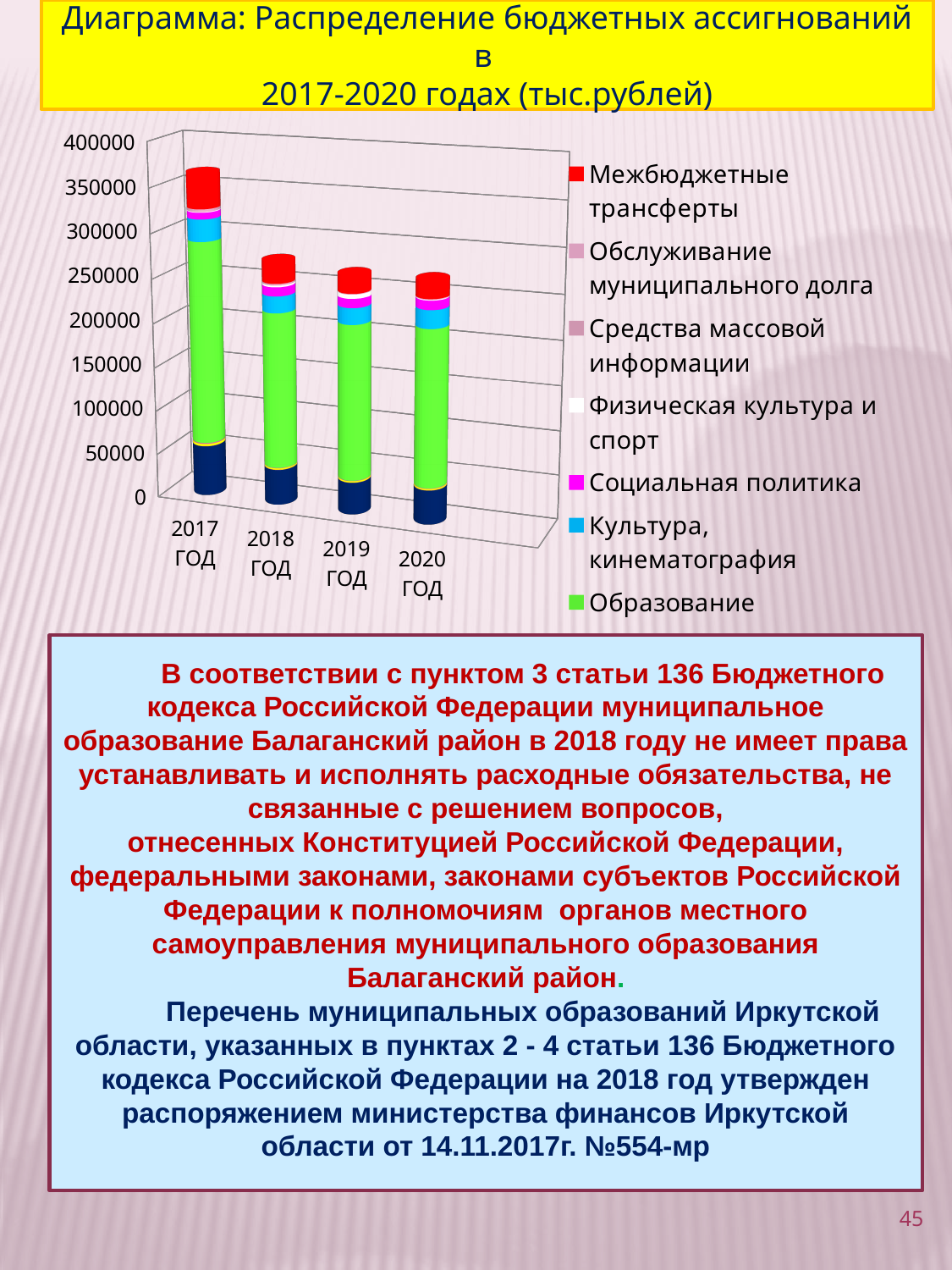
Which year has the highest total budget allocation in the chart? 2017 год Which series takes up the largest part of each bar in the chart? Образование Which total is larger, 2017 год or 2018 год? 2017 год Is the total value for 2020 год greater or less than 300000? less How many series does the chart legend list? 7 Do the total budget allocations rise or fall from 2017 to 2020? Fall How many years (categories) are shown on the x axis of the chart? 4 Is the total value for 2018 год greater or less than 250000? greater Is the total value for 2017 год greater or less than 300000? greater What colour represents the series 'Образование' in the chart? Green What kind of chart is shown on the slide? Stacked bar chart